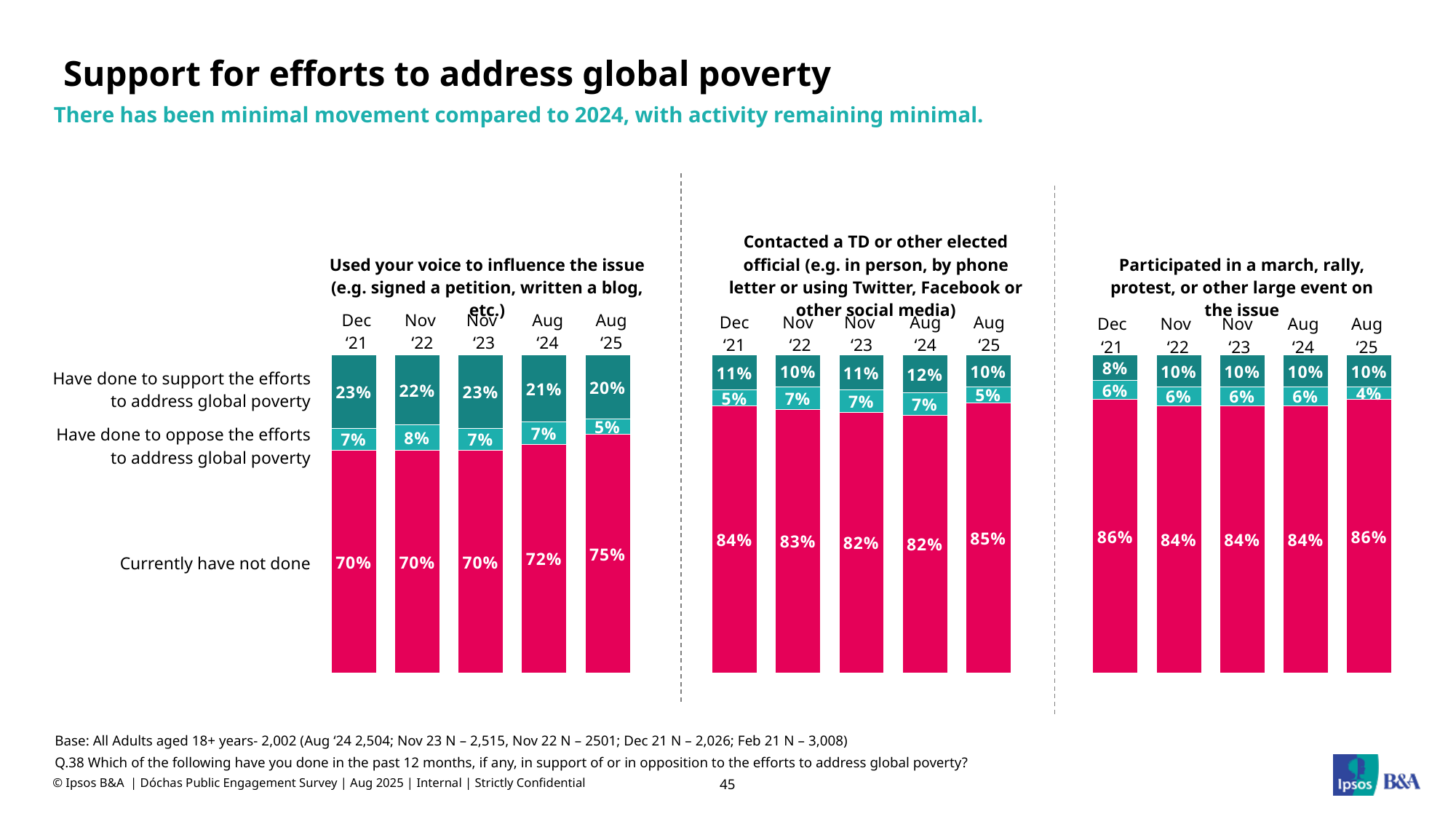
In the 'Participated in a march, rally, protest, or other large event' chart, what percentage had done something to support the efforts in Dec '21? 8% In the 'Contacted a TD or other elected official' chart, what percentage had done something to oppose the efforts in Nov '22? 7% In the 'Used your voice to influence the issue' chart, what is the difference between the 'Currently have not done' share in Aug '25 and in Dec '21? 5 percentage points How many series are shown in each stacked bar? 3 In the 'Contacted a TD or other elected official' chart, which wave has the highest share who have done something to support the efforts? Aug '24 In the 'Used your voice to influence the issue' chart, which wave has the lowest share who have done something to oppose the efforts? Aug '25 In the 'Used your voice to influence the issue' chart, what percentage currently have not done anything in Aug '25? 75% In the 'Participated in a march, rally, protest, or other large event' chart, is the 'Currently have not done' share larger in Aug '25 or in Aug '24? Aug '25 In the 'Used your voice to influence the issue' chart, does the 'Currently have not done' share rise or fall from Nov '23 to Aug '25? Rise How many survey waves are shown in each chart? 5 In the 'Used your voice to influence the issue' chart, what percentage had done something to support the efforts in Aug '25? 20% What type of chart is used on this slide? Stacked bar chart